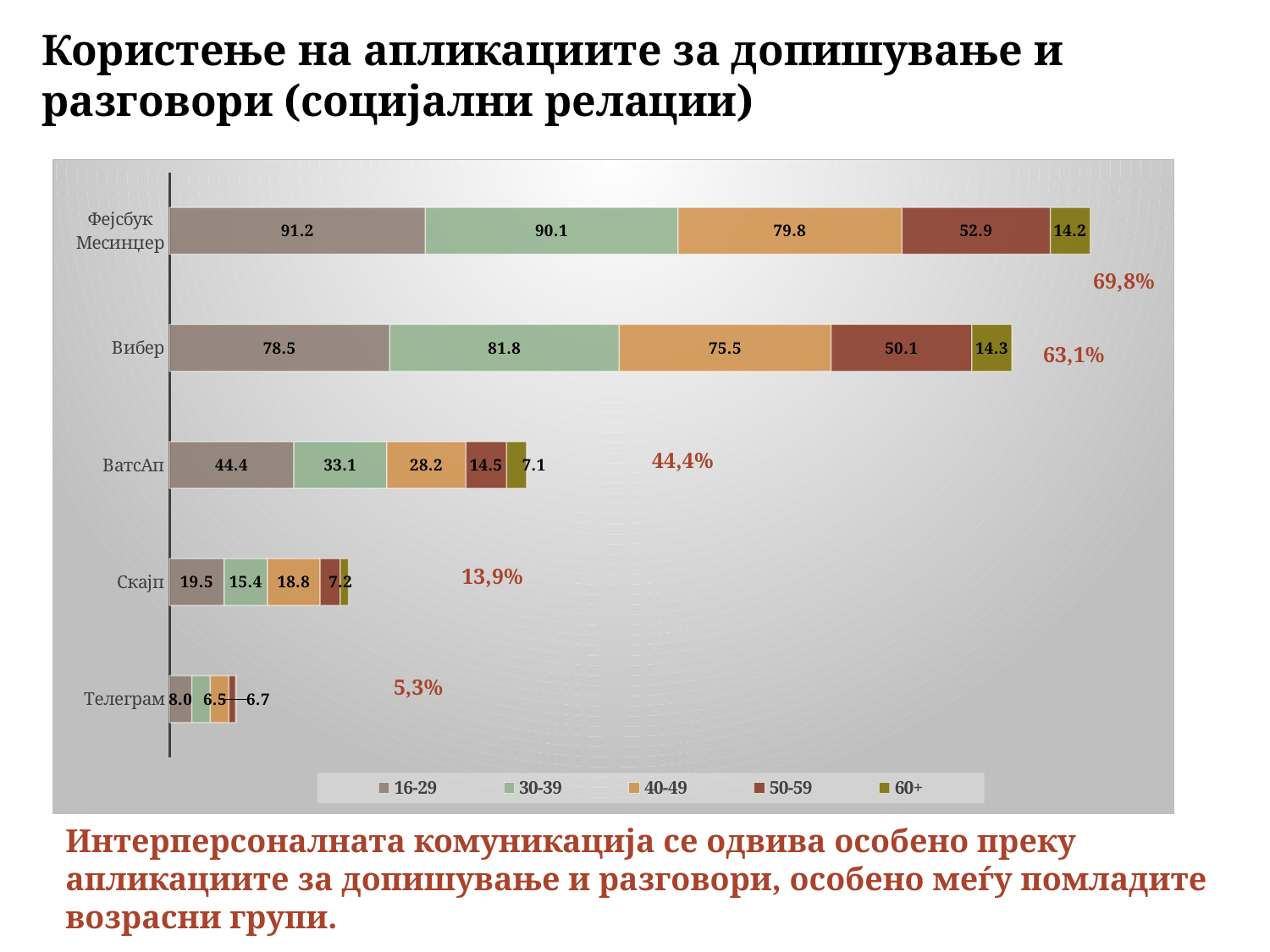
What is the value for the 40-49 age group for ВатсАп? 28.2 What is the difference between the 16-29 values for Фејсбук Месинџер and Вибер? 12.7 What is the value for the 30-39 age group for Вибер? 81.8 What is the value for the 50-59 age group for Скајп? 7.2 What is the total of the stacked bar for ВатсАп? 127.3 How many age groups does the legend list? 5 Which application has the highest value for the 16-29 age group? Фејсбук Месинџер What is the value for the 16-29 age group for Фејсбук Месинџер? 91.2 Which is larger, the 40-49 value for Фејсбук Месинџер or the 40-49 value for Вибер? Фејсбук Месинџер How many applications are shown on the chart? 5 What type of chart is shown on the slide? Stacked bar chart Which application has the lowest value for the 16-29 age group? Телеграм